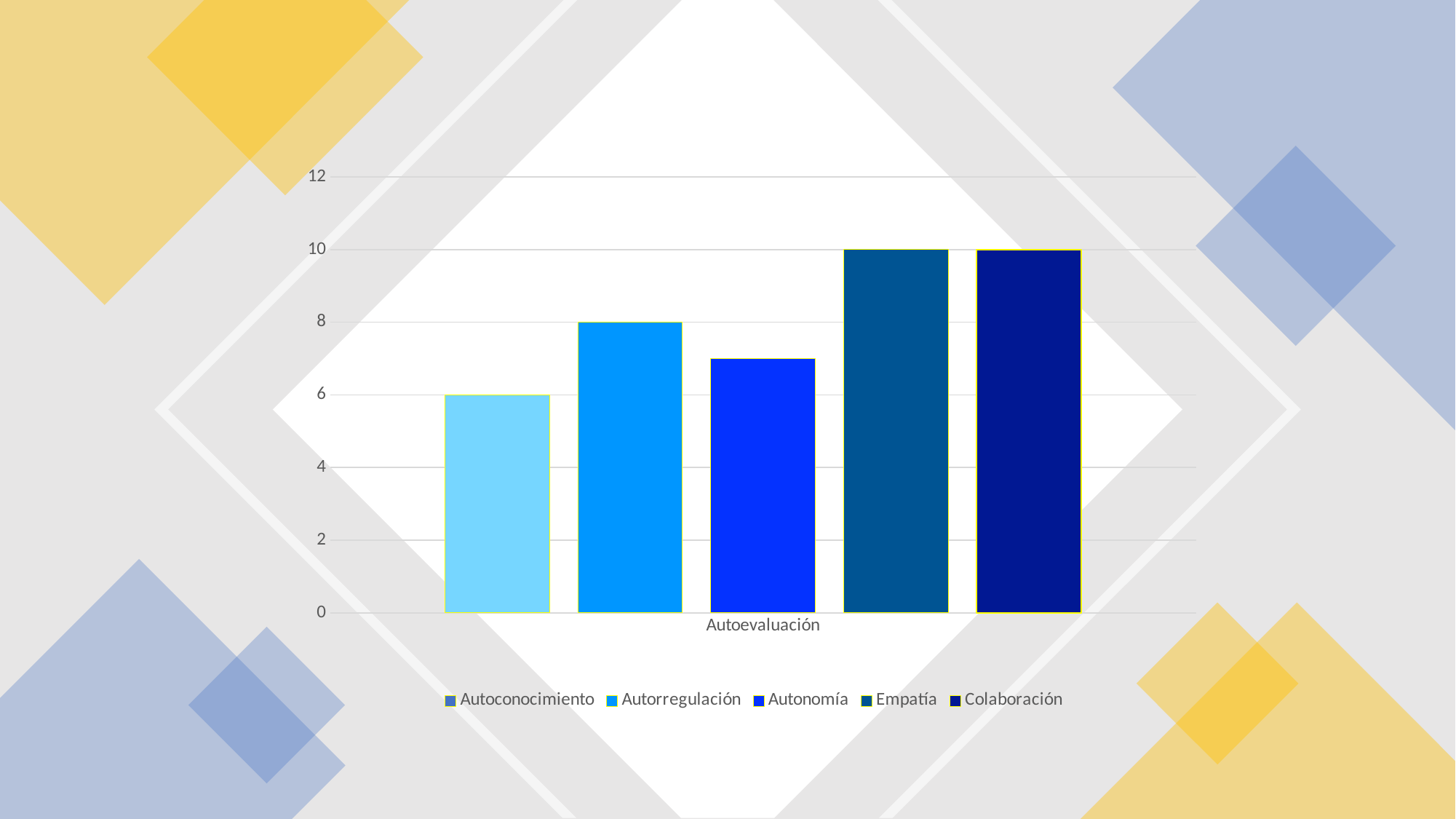
Which is larger, the value for Autorregulación or the value for Autonomía? Autorregulación Which series has the lowest value? Autoconocimiento Is the value for Autonomía greater or less than 8? less What kind of chart is shown on the slide? bar chart What is the difference between the values for Autorregulación and Autoconocimiento? 2 Is the value for Autonomía greater or less than 6? greater What is the value for Empatía? 10 What is the value for Colaboración? 10 What is the value for Autorregulación? 8 What is the category label shown on the x axis? Autoevaluación What is the value for Autoconocimiento? 6 How many series does the legend list? 5